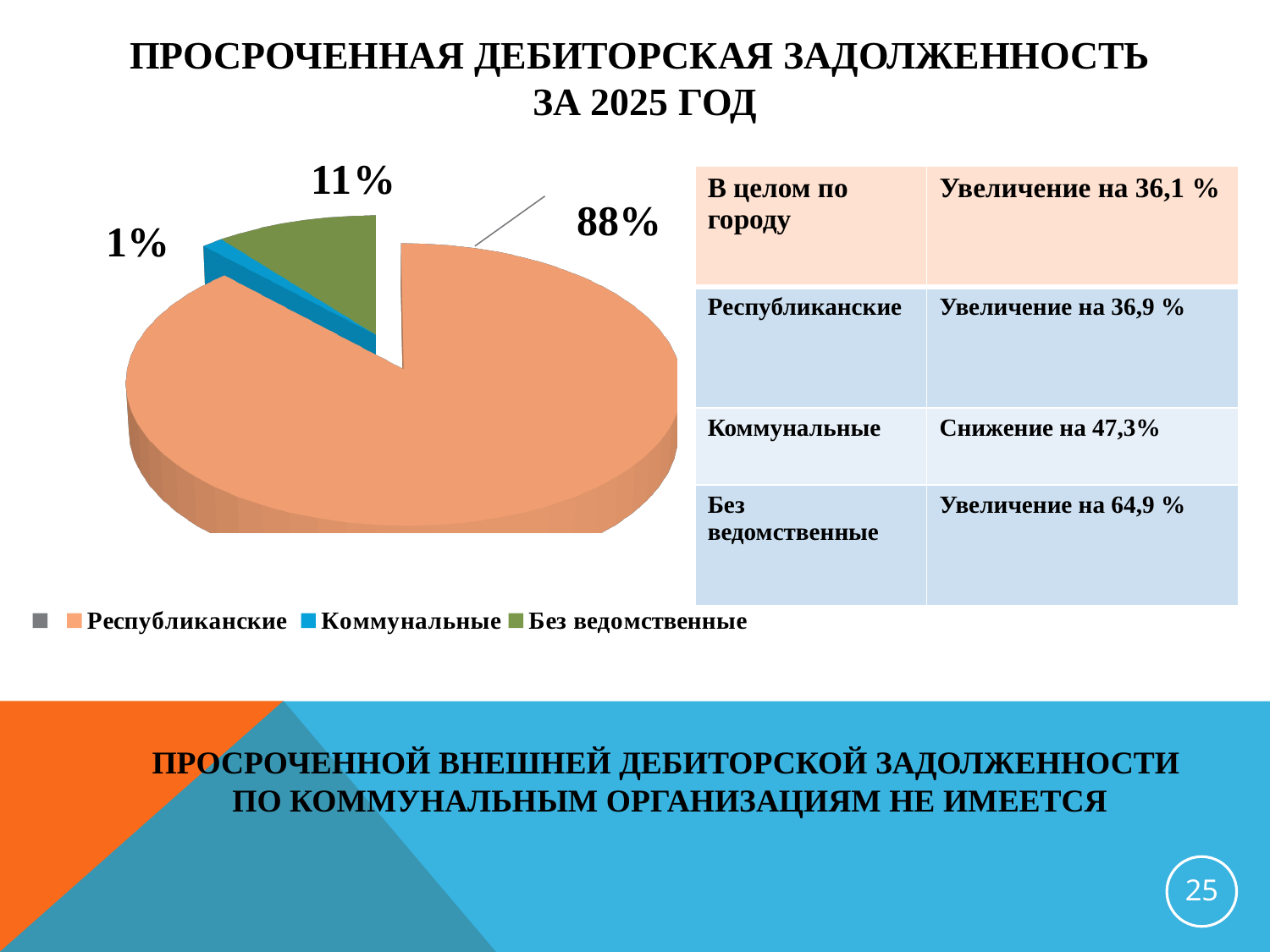
How many slices of the pie are labeled with a percentage? 3 What share of the pie does the Республиканские slice represent? 88% Which category has the largest slice of the pie? Республиканские What is the difference in percentage points between the Республиканские slice and the Без ведомственные slice? 77 percentage points Which category has the smallest slice of the pie? Коммунальные Which slice is larger, Без ведомственные or Коммунальные? Без ведомственные What kind of chart is shown on the slide? pie chart What is the difference in percentage points between the Без ведомственные slice and the Коммунальные slice? 10 percentage points What share of the pie does the Коммунальные slice represent? 1% What colour is the Коммунальные slice in the pie chart? blue What colour is the Республиканские slice in the pie chart? orange What share of the pie does the Без ведомственные slice represent? 11%